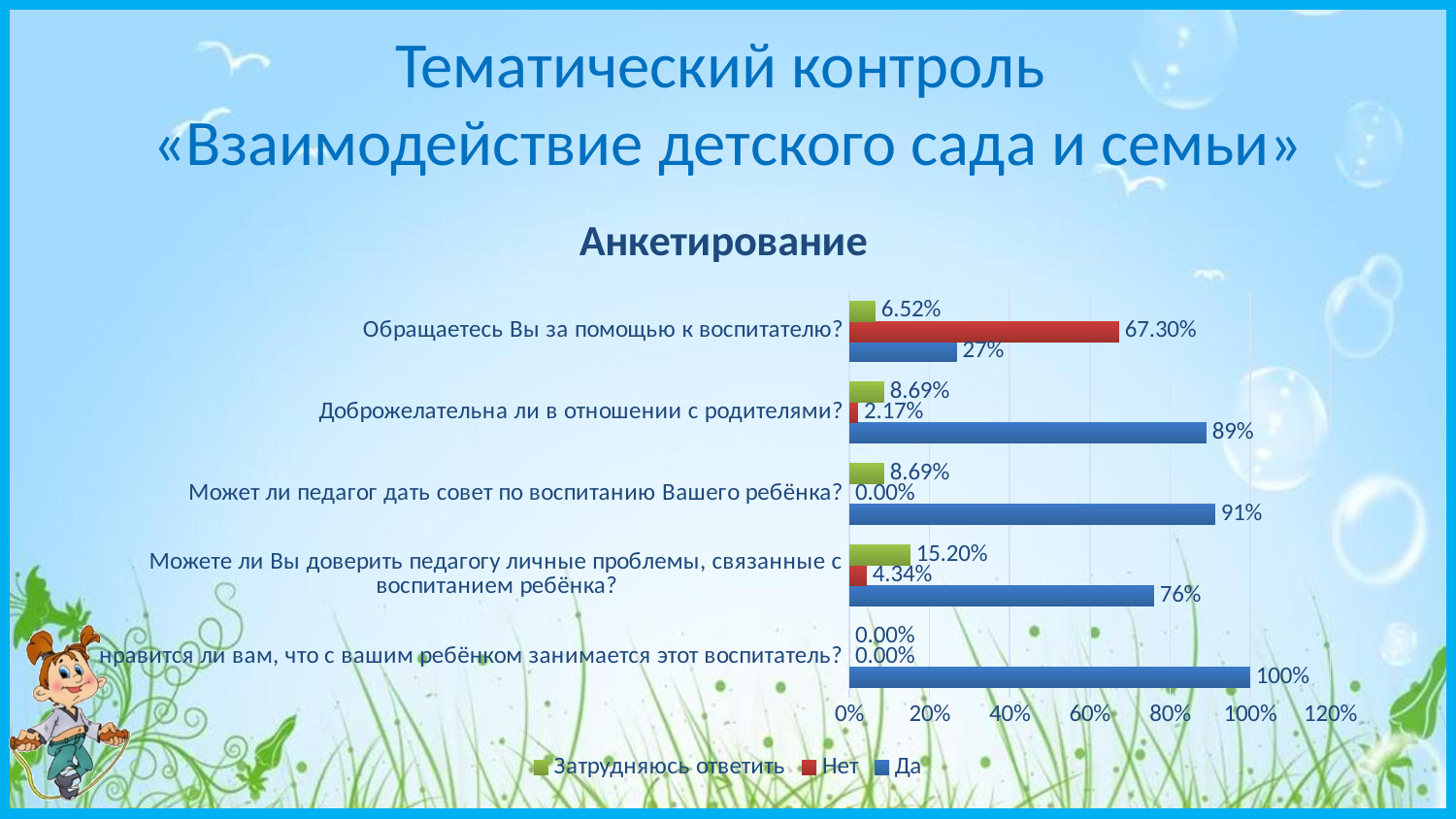
Which colour represents the "Нет" series in the chart? Red How many categories (questions) are shown on the chart? 5 What is the value of the "Да" series for "Нравится ли вам, что с вашим ребёнком занимается этот воспитатель?"? 100% Which category has the highest value in the "Да" series? Нравится ли вам, что с вашим ребёнком занимается этот воспитатель? How many series does the legend list? 3 What is the value of the "Нет" series for "Обращаетесь Вы за помощью к воспитателю?"? 67.30% What is the difference between the "Да" values for "Может ли педагог дать совет по воспитанию Вашего ребёнка?" and "Доброжелательна ли в отношении с родителями?"? 2% What type of chart is shown on the slide? Bar chart For "Доброжелательна ли в отношении с родителями?", which is larger: the "Затрудняюсь ответить" value or the "Нет" value? Затрудняюсь ответить What is the value of the "Затрудняюсь ответить" series for "Можете ли Вы доверить педагогу личные проблемы, связанные с воспитанием ребёнка?"? 15.20% Which category has the lowest value in the "Да" series? Обращаетесь Вы за помощью к воспитателю? What is the value of the "Да" series for "Обращаетесь Вы за помощью к воспитателю?"? 27%